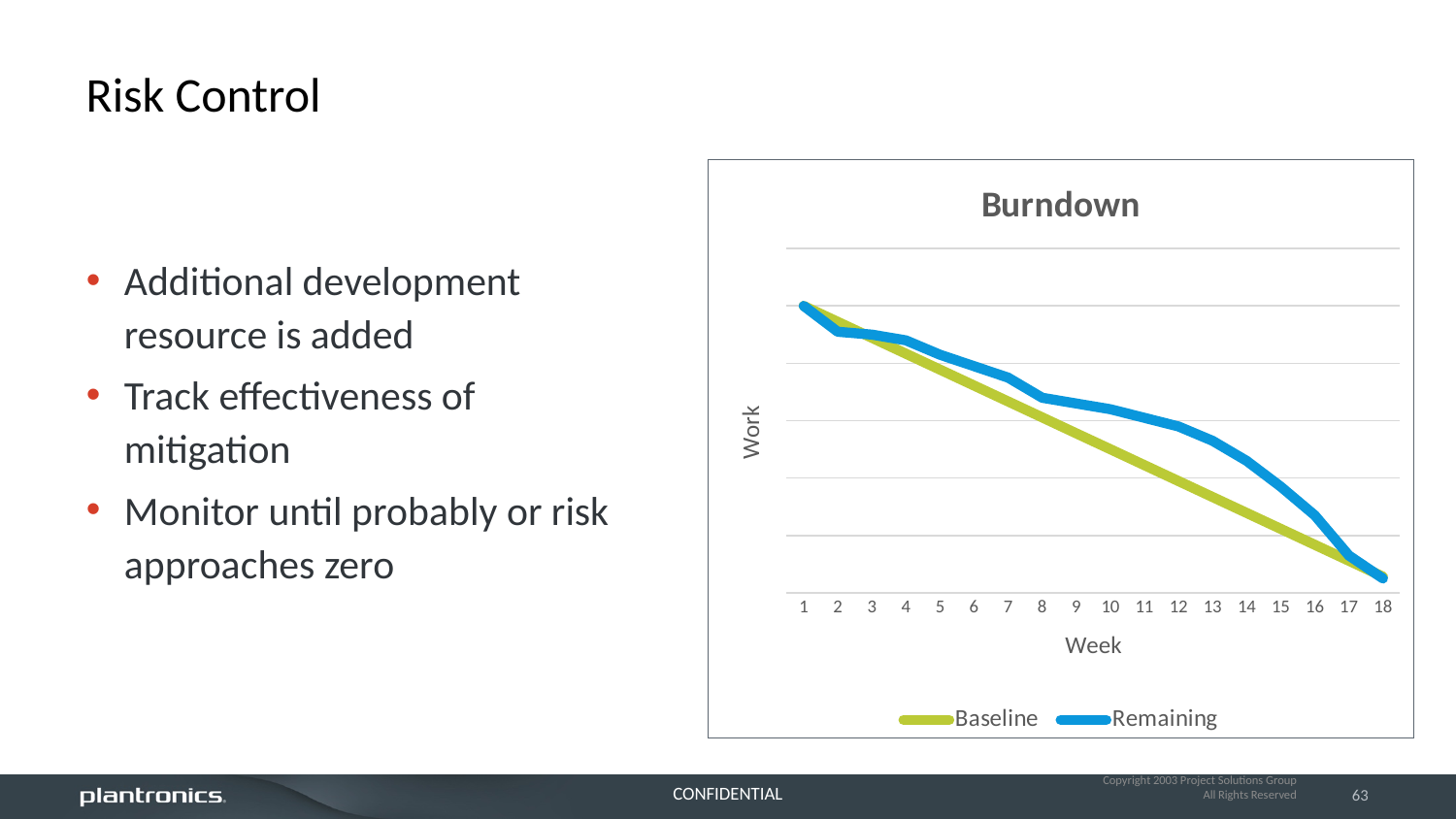
At week 8, is the Remaining line above or below the Baseline line? above What is the title of the chart on the slide? Burndown Do the values of the Baseline series rise or fall as the week number increases? fall At week 12, which series has the higher value, Baseline or Remaining? Remaining What kind of chart is the Burndown chart? line chart How many series does the legend of the Burndown chart list? 2 Do the values of the Remaining series rise or fall from week 1 to week 18? fall What is the label of the x axis of the Burndown chart? Week How many weeks are shown on the x axis of the Burndown chart? 18 Which series is lower at week 14, Baseline or Remaining? Baseline